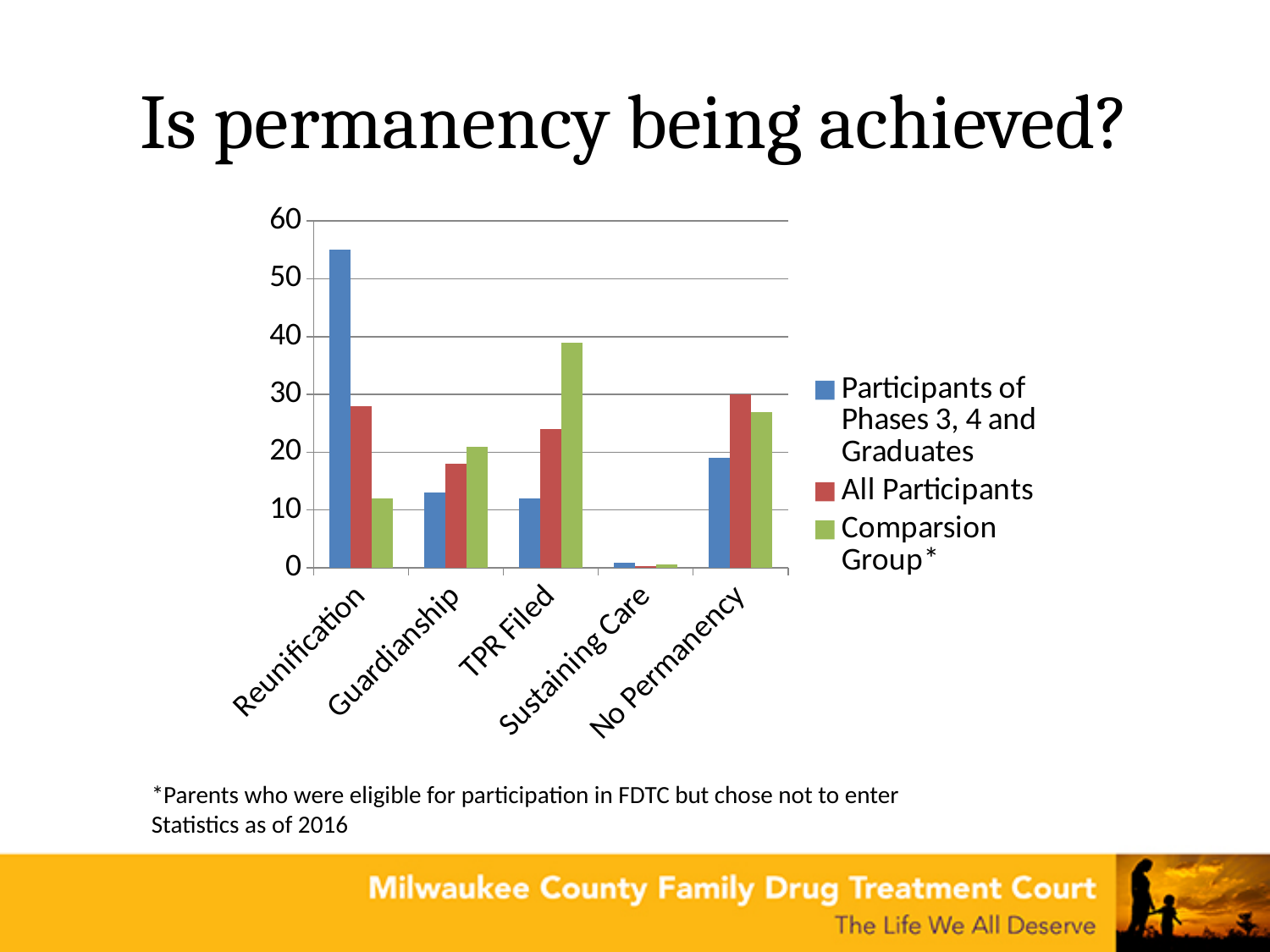
Which category has the highest value for the Participants of Phases 3, 4 and Graduates series? Reunification For TPR Filed, which series has the larger value: Comparsion Group* or Participants of Phases 3, 4 and Graduates? Comparsion Group* For Reunification, which series has the larger value: Participants of Phases 3, 4 and Graduates or All Participants? Participants of Phases 3, 4 and Graduates What kind of chart is shown on the slide? bar chart Is the Reunification value for the Comparsion Group* greater or less than 20? less Which category has the lowest value for the All Participants series? Sustaining Care Is the Reunification value for Participants of Phases 3, 4 and Graduates greater or less than 50? greater Is the TPR Filed value for the Comparsion Group* greater or less than 30? greater Which category has the highest value for the Comparsion Group* series? TPR Filed How many series does the chart's legend list? 3 How many categories are shown on the x axis of the chart? 5